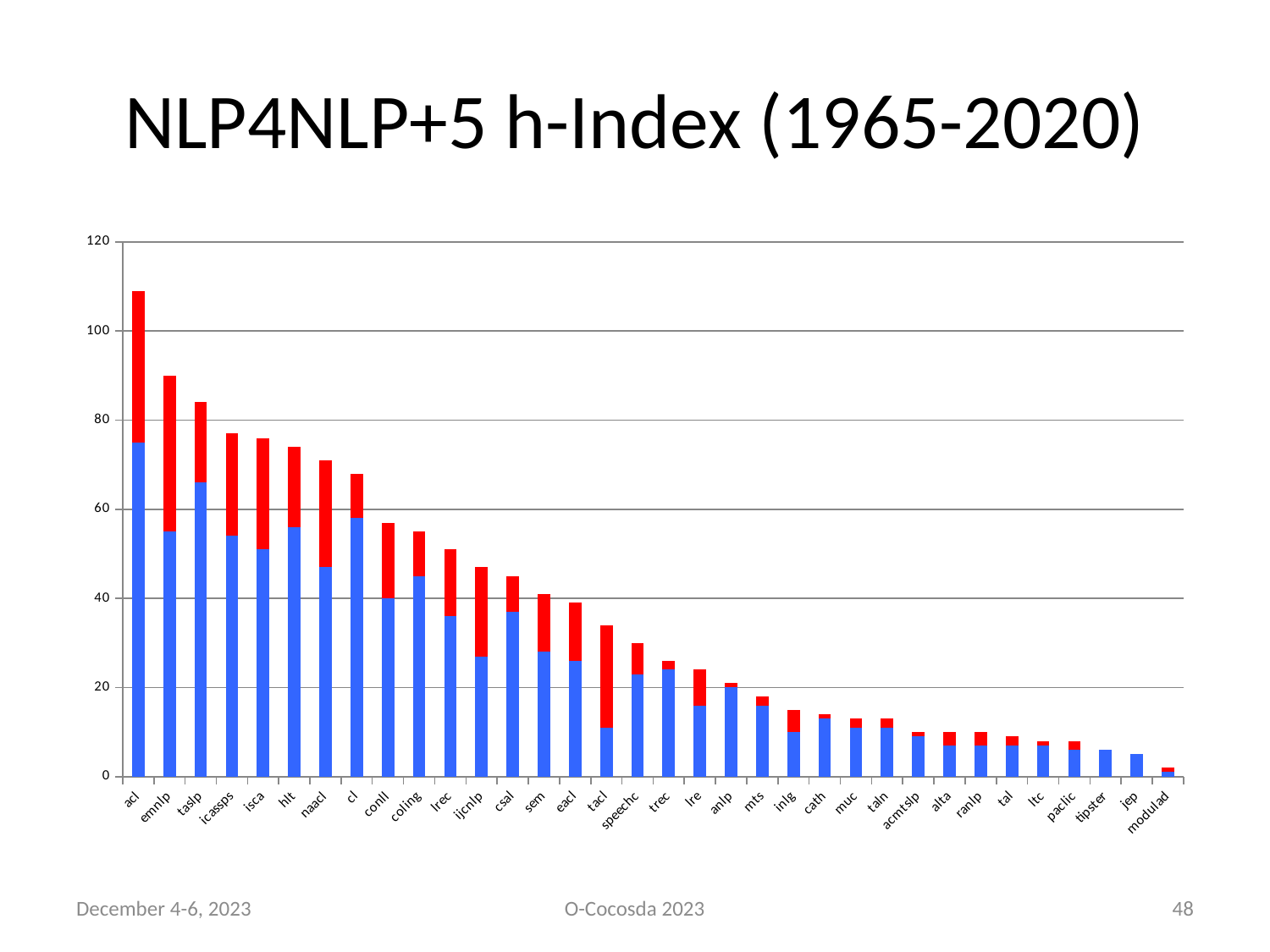
Is the total bar height for tacl greater or less than 40? less What kind of chart is shown on the slide? stacked bar chart Is the total bar height for acl greater or less than 100? greater Is the total bar height for modulad greater or less than 20? less Which has a taller bar, lrec or trec? lrec How many categories are shown on the x axis? 34 What is the title of the chart? NLP4NLP+5 h-Index (1965-2020) Which category has the shortest bar? modulad Which category has the tallest bar? acl Do the bar heights generally rise or fall from left to right along the x axis? fall Which has a taller bar, acl or emnlp? acl